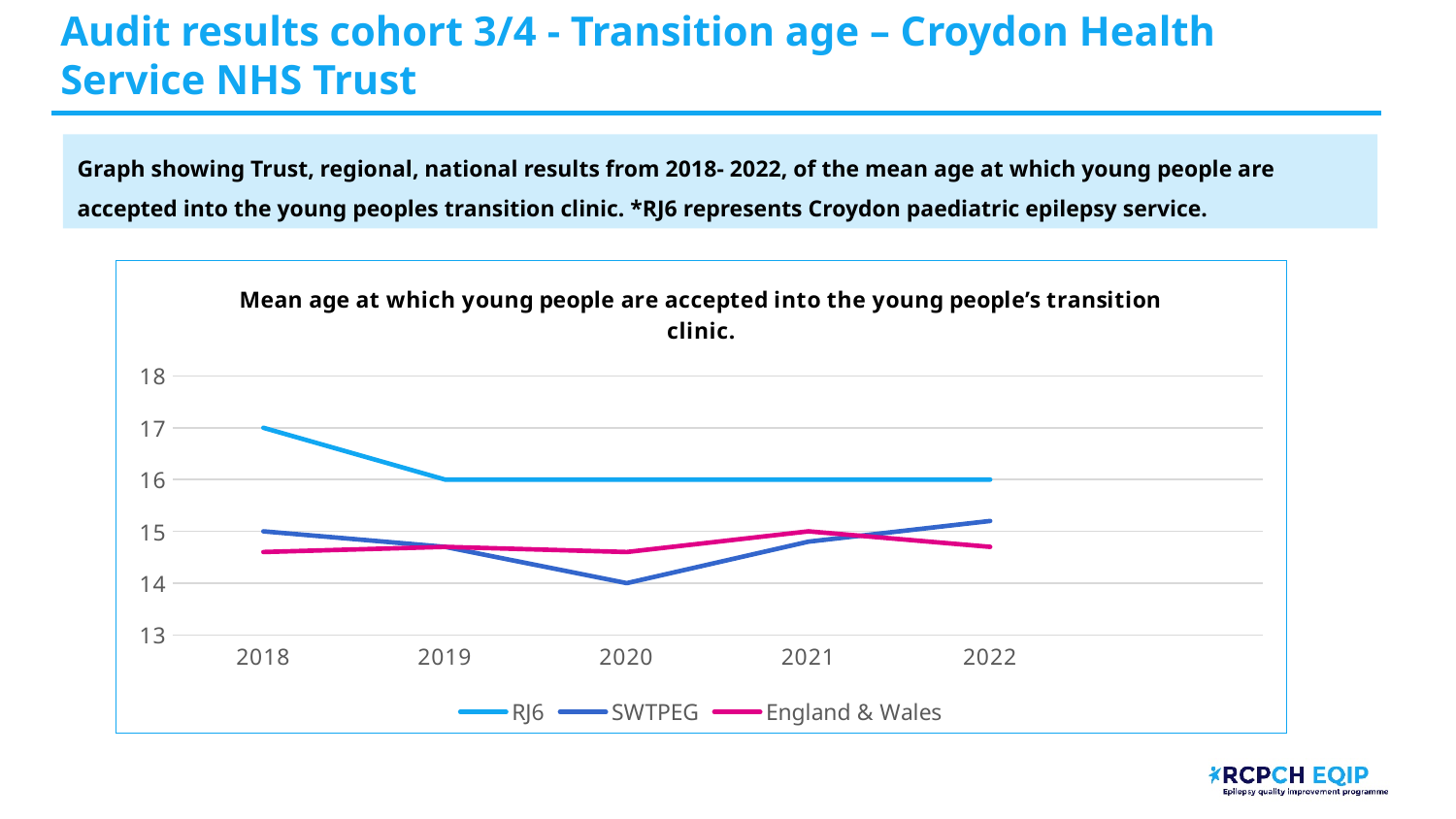
Does the RJ6 line rise or fall from 2018 to 2019? Fall How many years are shown on the x axis of the chart? 5 What kind of chart is shown on the slide? Line chart Which series has the highest value in 2018? RJ6 Which is larger in 2022, the value for SWTPEG or the value for England & Wales? SWTPEG What is the value for SWTPEG in 2018? 15 What is the value for SWTPEG in 2020? 14 How many series does the chart legend list? 3 Which series has the lowest value in 2020? SWTPEG What is the value for RJ6 in 2018? 17 What is the value for RJ6 in 2022? 16 Is the value for England & Wales in 2020 greater or less than 15? less